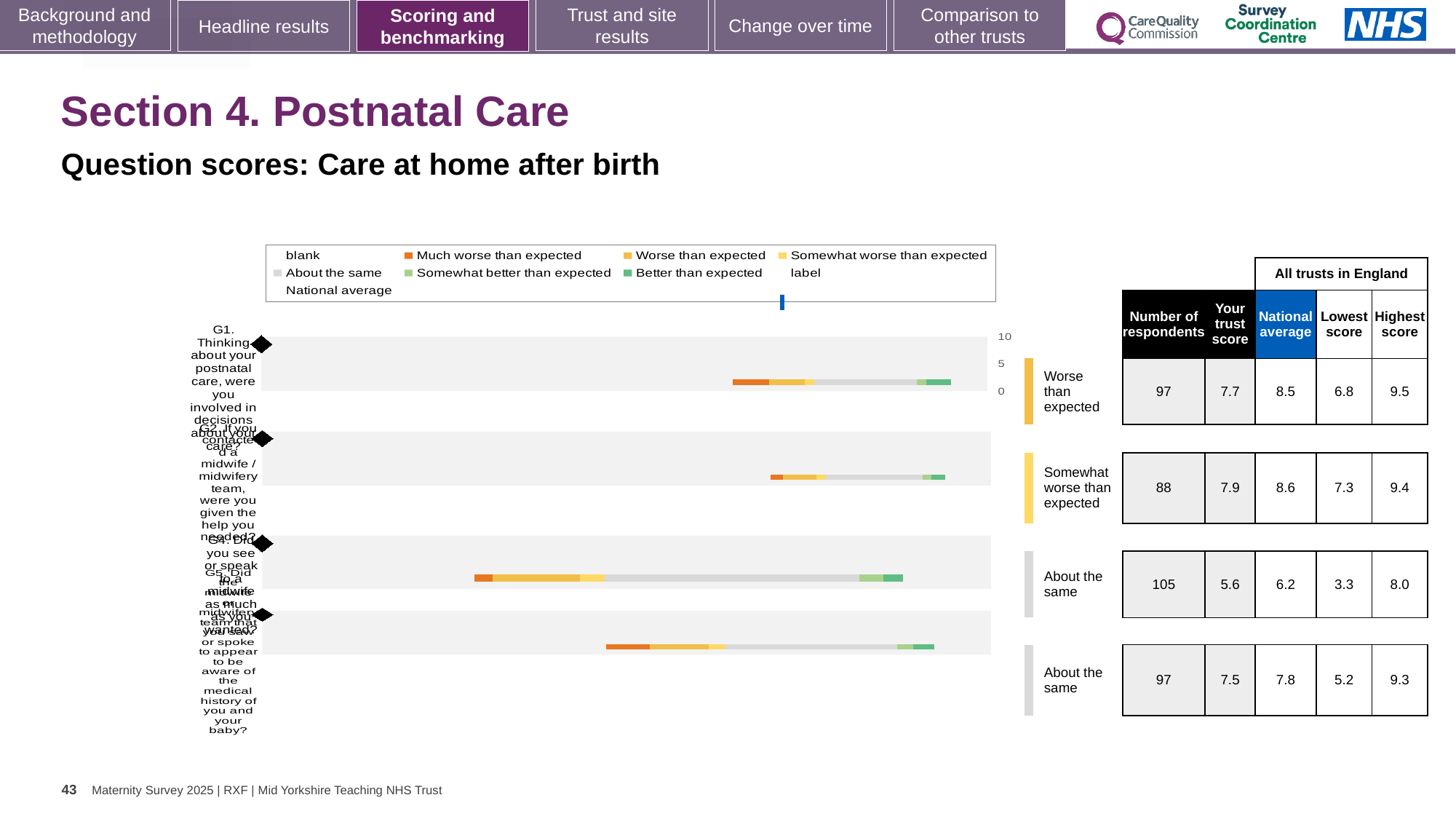
In the table beside the chart, which question has the highest number of respondents? G4 In the table beside the chart, is the trust score for G2 larger or smaller than the trust score for G5? larger In the table beside the chart, what is the national average for G4? 6.2 In the table beside the chart, how many respondents answered G2? 88 How many survey questions (bars) are plotted in the chart? 4 What kind of chart is shown on the slide? bar chart What is the highest value shown on the chart's score axis? 10 In the table beside the chart, what is the difference between the national average and the trust score for G1? 0.8 In the table beside the chart, which question has the lowest trust score? G4 What benchmark category is shown next to the G1 bar? Worse than expected Which colour does the legend use for 'Much worse than expected'? orange In the table beside the chart, what is the trust score for G1? 7.7